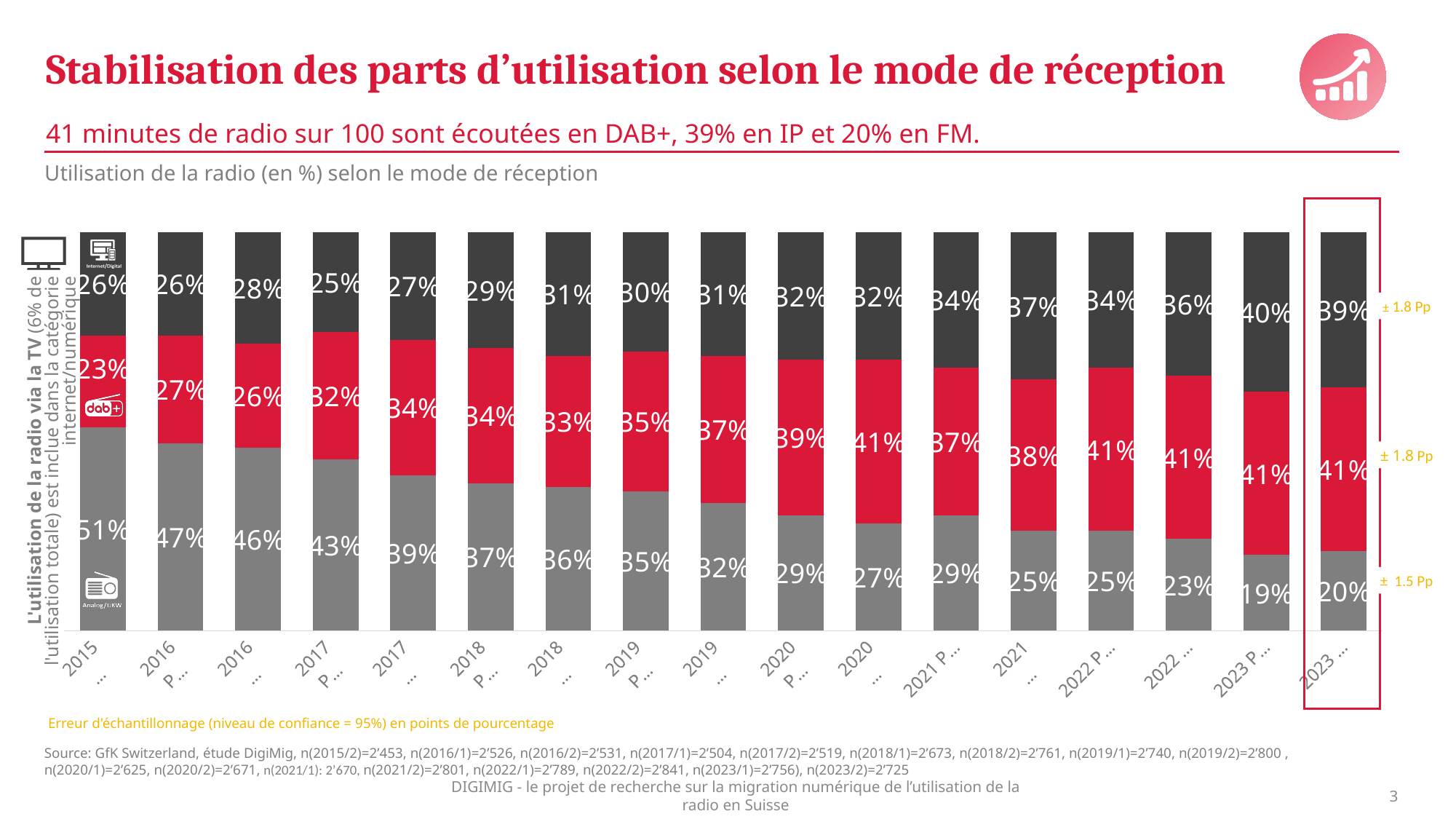
Does the Analog/UKW (grey) share rise or fall from the first bar (2015) to the last bar (2023)? Fall What is the Internet/Digital (dark) share in the last, highlighted bar (2023)? 39% By how many percentage points did the Analog/UKW share drop between the first bar (51%) and the last bar (20%)? 31 percentage points How many reception modes (series) are stacked in each bar? 3 What is the DAB+ (red) share in the last, highlighted bar (2023)? 41% In the last, highlighted bar (2023), which is larger: the DAB+ share or the Internet/Digital share? DAB+ What is the Internet/Digital (dark) share in the first bar, 2015? 26% What is the Analog/UKW (grey) share in the first bar, 2015? 51% Which reception mode has the largest share in the first bar, 2015? Analog/UKW How many bars (survey waves) are plotted in the chart? 17 What type of chart is shown on the slide? Stacked bar chart What sampling error is shown next to the DAB+ segment of the last bar? ± 1.8 Pp